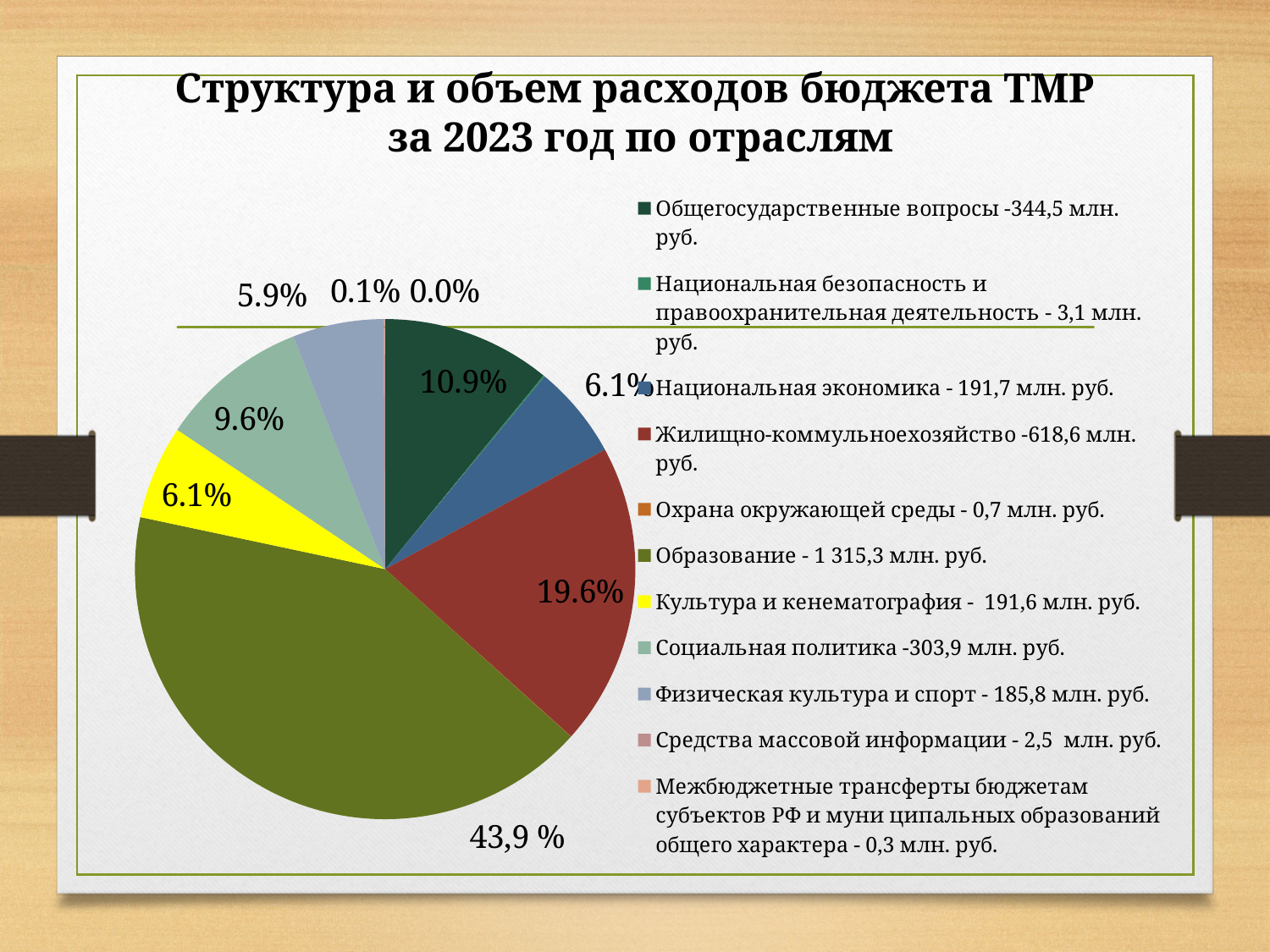
What kind of chart is shown on the slide? pie chart According to the legend, what is the amount for Образование? 1 315,3 млн. руб. How many categories does the legend of the pie chart list? 11 Which category has the largest share of the pie? Образование What share of the pie does Общегосударственные вопросы take? 10.9% What is the difference between the amounts for Жилищно-коммульноехозяйство and Общегосударственные вопросы? 274,1 млн. руб. What share of the pie does Социальная политика take? 9.6% Which is larger: the amount for Социальная политика or for Физическая культура и спорт? Социальная политика Which category has the smallest amount according to the legend? Межбюджетные трансферты бюджетам субъектов РФ и муниципальных образований общего характера What share of the pie does Образование take? 43,9 % According to the legend, what is the amount for Жилищно-коммульноехозяйство? 618,6 млн. руб.